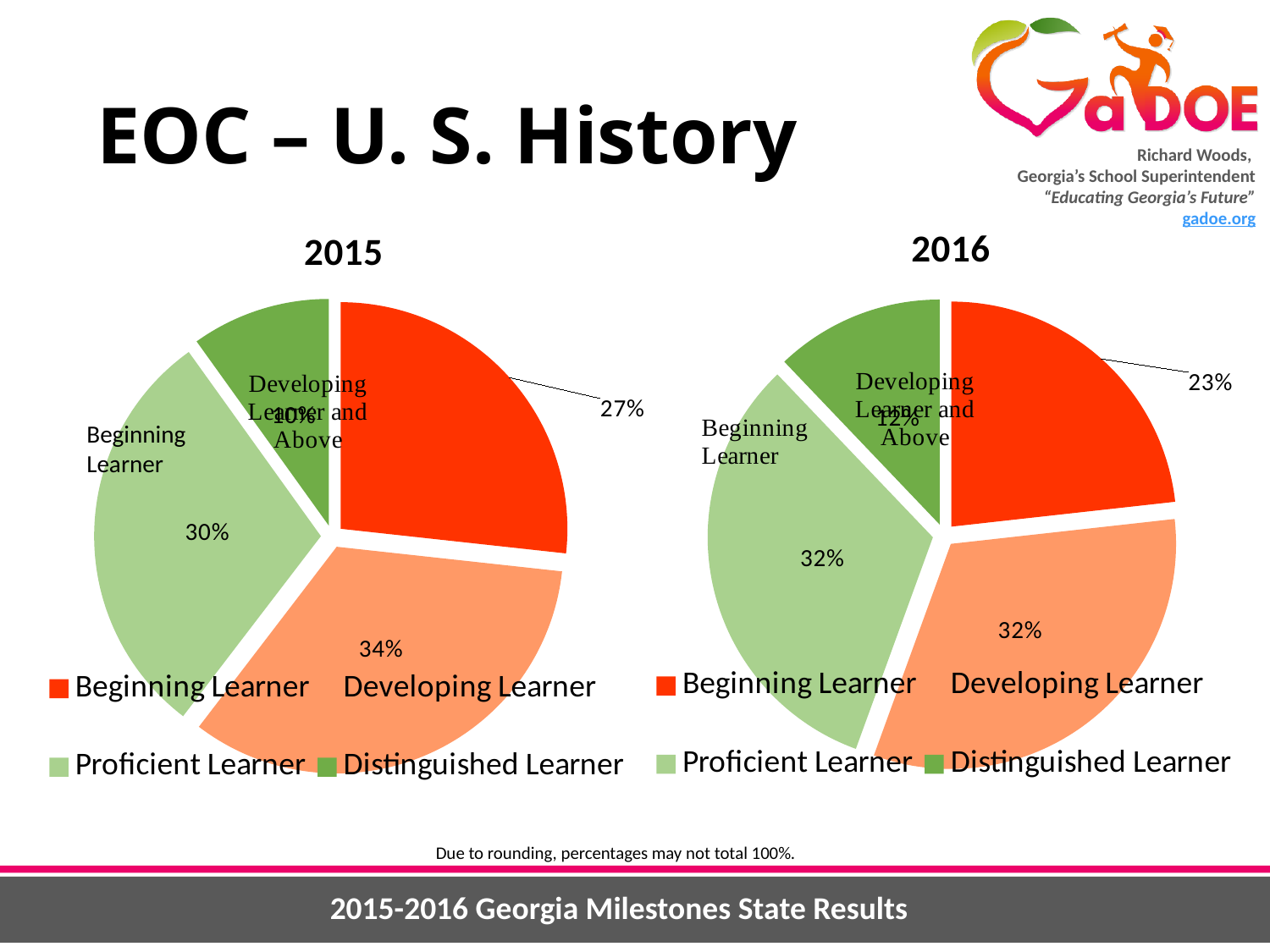
In the 2015 pie chart, what percentage is shown for Developing Learner? 34% In the 2016 pie chart, which category has the smallest share? Distinguished Learner How many categories does the legend of the 2016 pie chart list? 4 In the 2015 pie chart, what percentage is shown for Proficient Learner? 30% What is the difference between the Beginning Learner percentage in 2015 and in 2016? 4 percentage points What type of chart is used for the 2015 and 2016 results? Pie chart In the 2016 pie chart, what percentage is shown for Developing Learner? 32% In the 2016 pie chart, what percentage is shown for Beginning Learner? 23% In the 2015 pie chart, what percentage is shown for Beginning Learner? 27% In the 2015 pie chart, which category has the largest share? Developing Learner In the 2016 pie chart, what percentage is shown for Proficient Learner? 32% Which is larger: the Developing Learner share in 2015 or the Developing Learner share in 2016? 2015